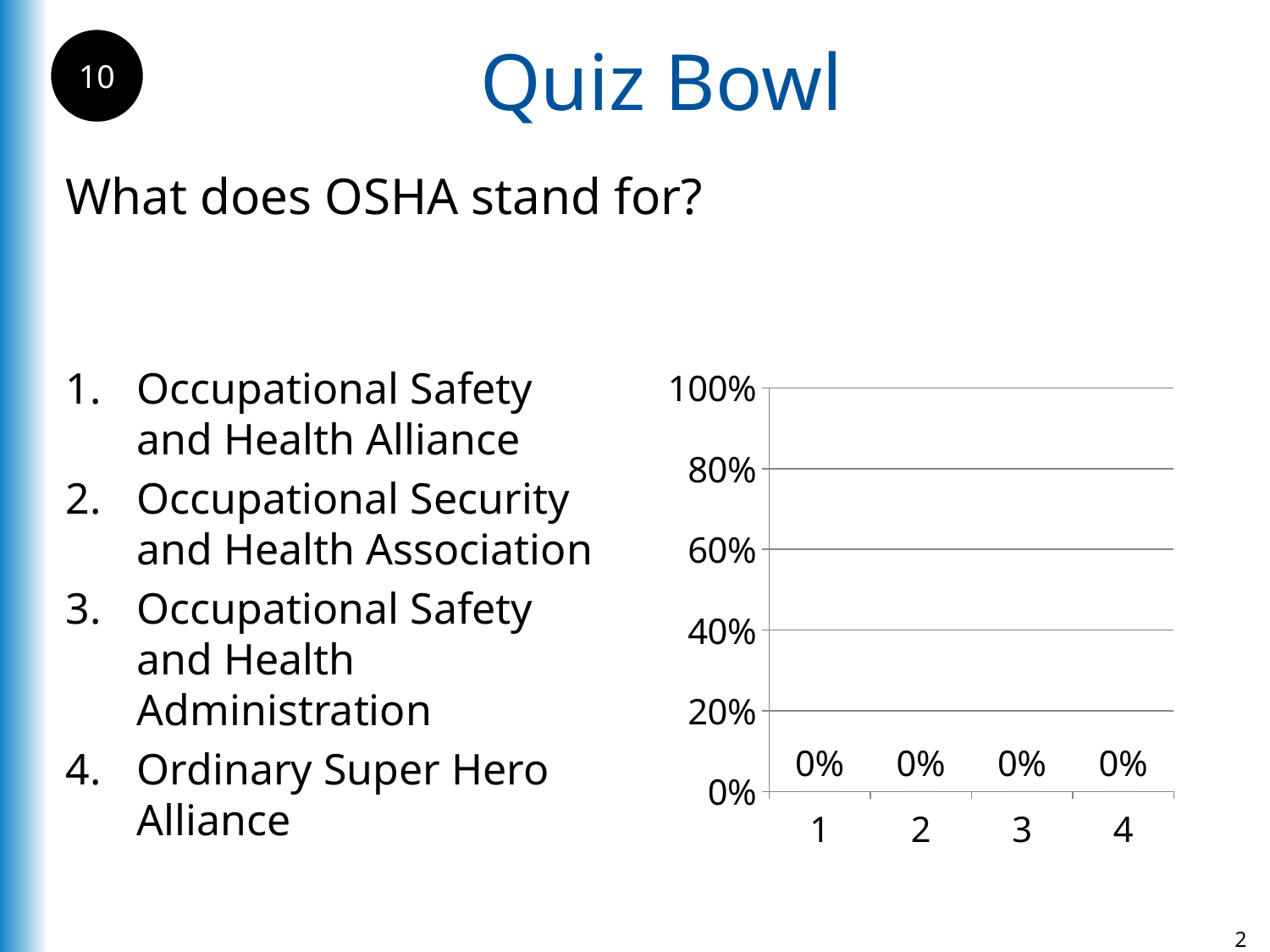
Is the value for category 2 greater or less than 20%? less Is the value for category 4 greater or less than 40%? less What is the value shown for category 1? 0% What is the value shown for category 4? 0% What is the highest value labelled on the vertical axis of the chart? 100% How many categories are shown on the x axis of the chart? 4 What is the difference between the values for category 2 and category 4? 0% Do all four categories in the chart show the same value? Yes What is the interval between tick labels on the vertical axis? 20% What is the value shown for category 3? 0%